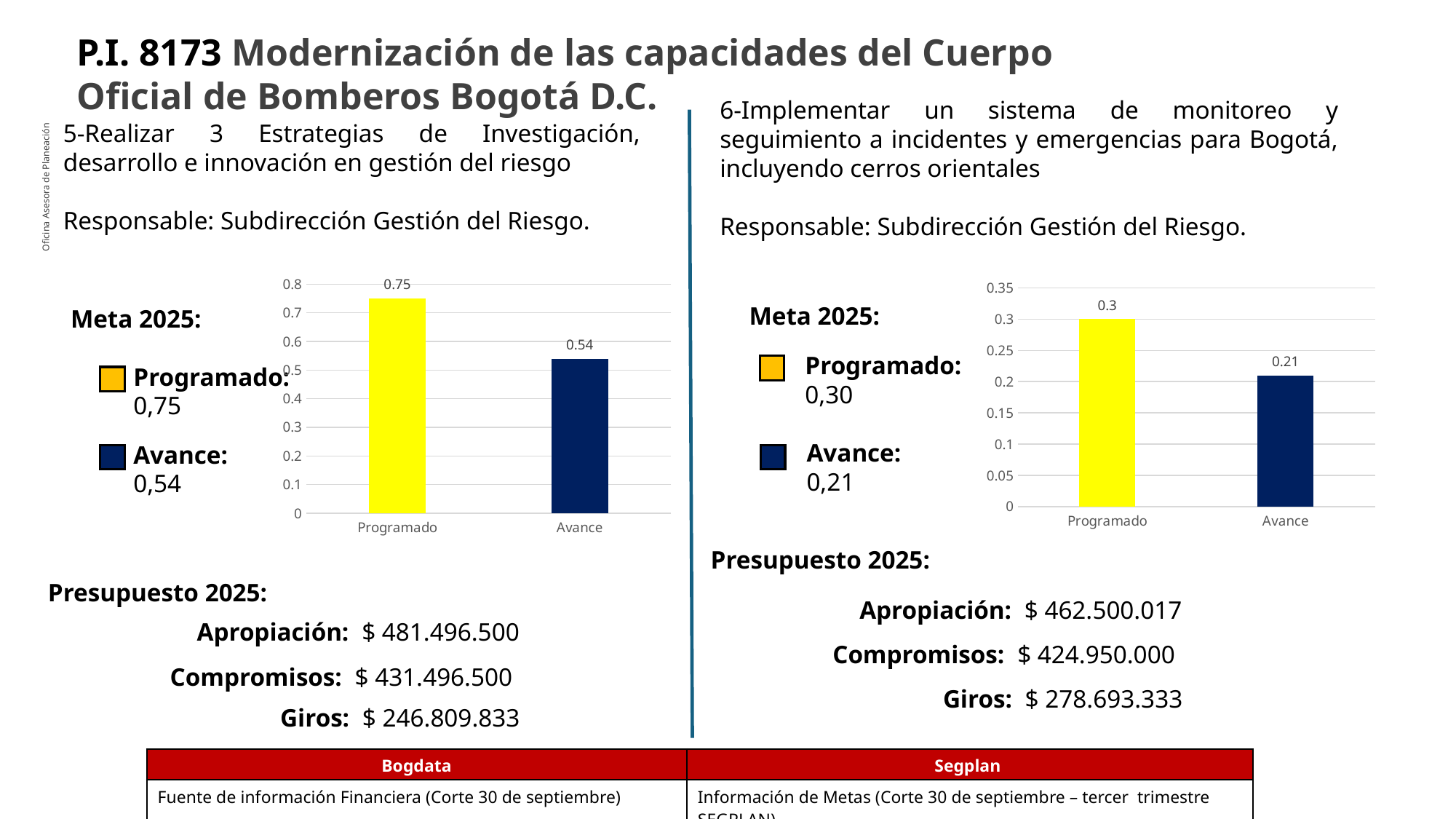
In the right chart, is the value for Avance greater or less than 0.25? less In the left chart, what is the difference between Programado and Avance? 0.21 In the right chart, what is the value for Avance? 0.21 In the left chart, what colour is the Programado bar? yellow In the right chart, which category has the lower value? Avance What type of chart is the right chart? bar chart In the left chart, what is the value for Programado? 0.75 How many bars are shown in the left chart? 2 In the left chart, which category has the higher value? Programado In the right chart, what is the difference between Programado and Avance? 0.09 In the right chart, what is the value for Programado? 0.3 In the left chart, what is the value for Avance? 0.54